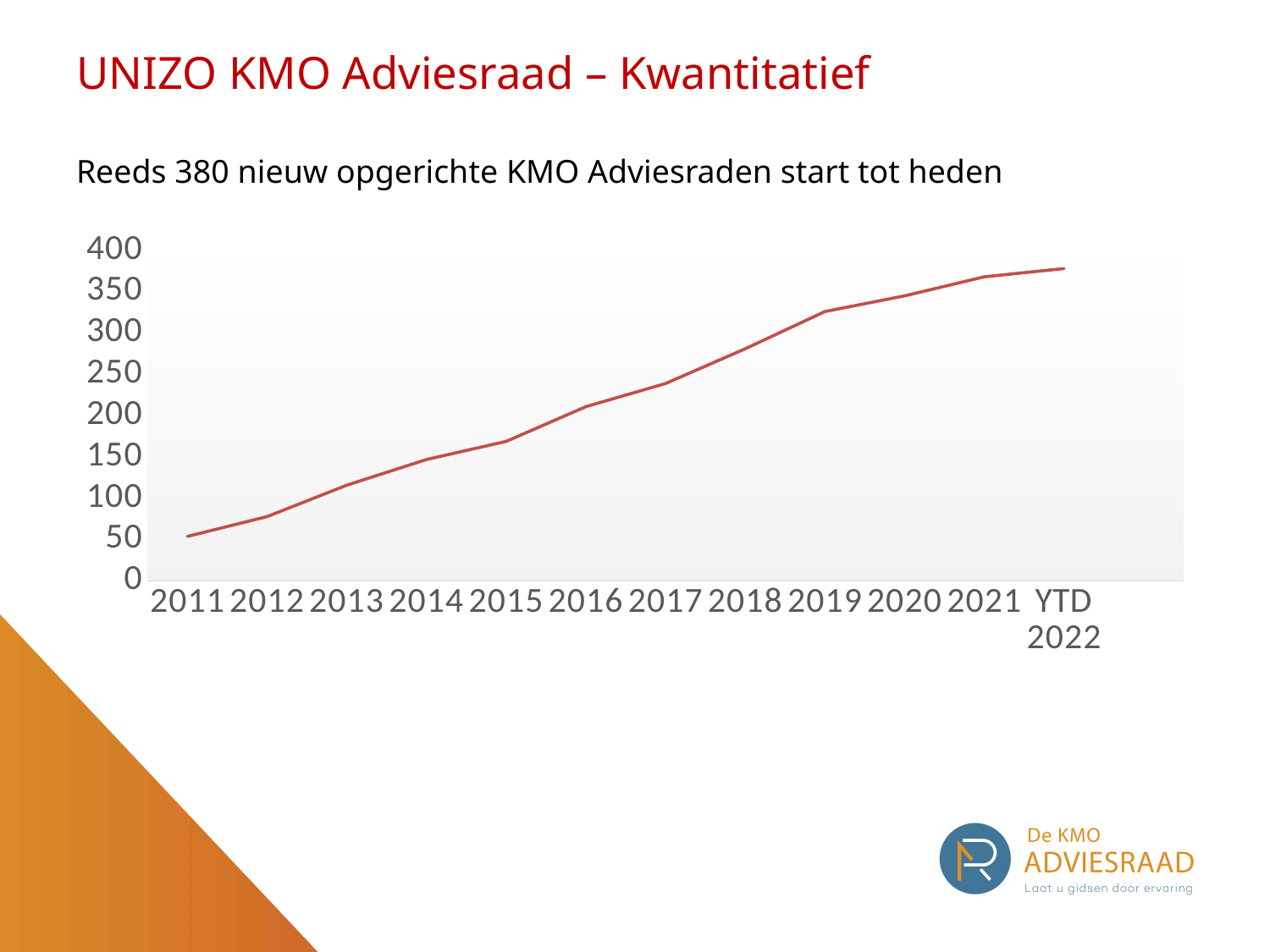
What kind of chart is shown on the slide? line chart How many points (years) are plotted along the x axis? 12 Is the value for 2015 greater or less than 200? less Which year has the highest value on the chart? YTD 2022 Which year has the lowest value on the chart? 2011 Which is larger, the value for 2016 or the value for 2019? 2019 Is the value for 2014 greater or less than 200? less Is the value for 2018 greater or less than 250? greater What is the highest value shown on the y axis? 400 Do the values rise or fall from 2011 to YTD 2022? rise